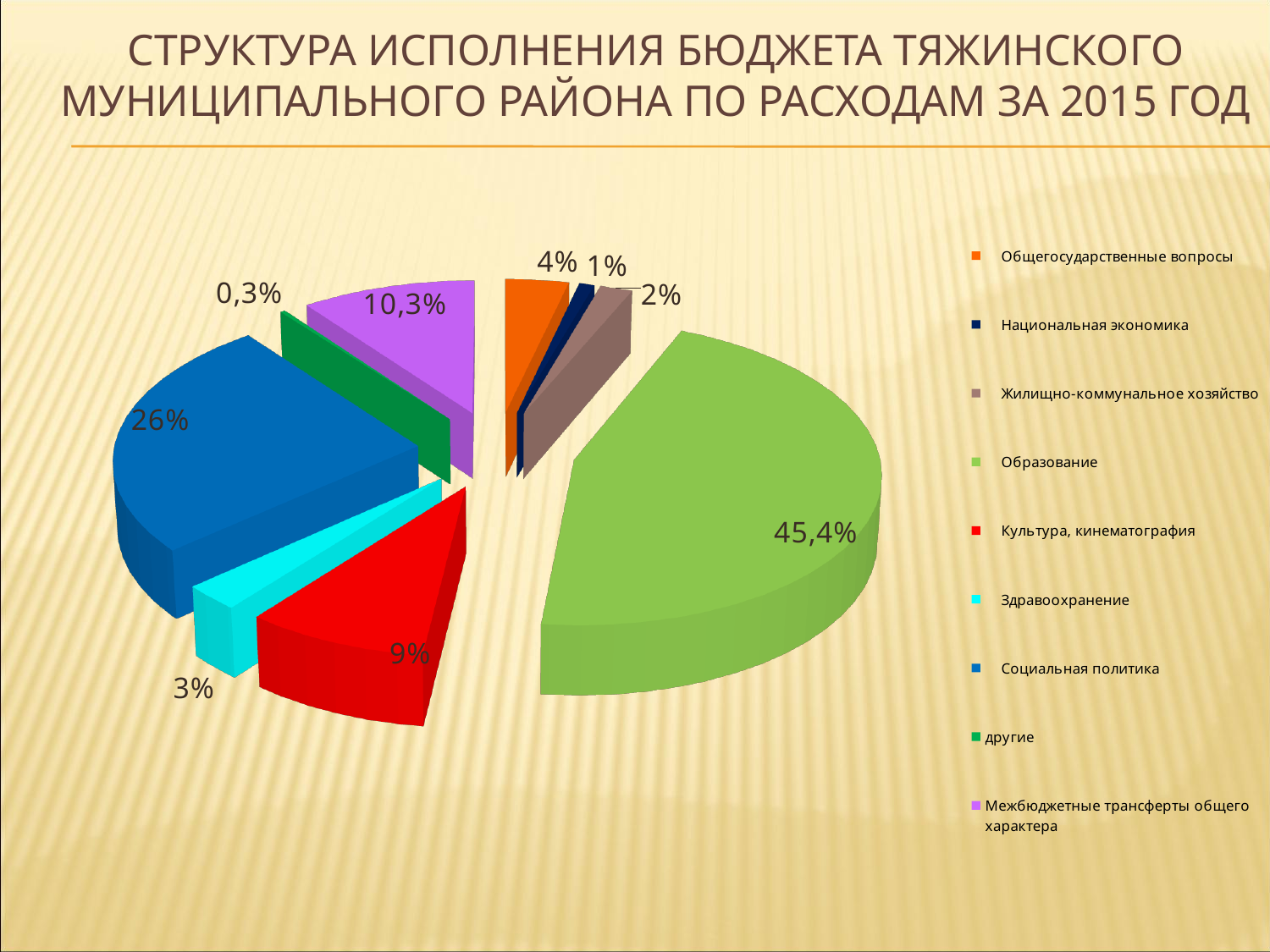
Which category has the smallest share of the pie? другие What percentage is shown for Культура, кинематография? 9% What share of the budget expenditure is labelled for Образование? 45,4% What percentage is shown for Социальная политика? 26% What percentage is shown for Общегосударственные вопросы? 4% What is the difference between the shares for Образование and Социальная политика? 19,4% What percentage is shown for Межбюджетные трансферты общего характера? 10,3% How many categories does the legend list? 9 What kind of chart is shown on the slide? Pie chart Which category has the largest share of the pie? Образование Which is larger, the share for Социальная политика or the share for Межбюджетные трансферты общего характера? Социальная политика What percentage is shown for the category другие? 0,3%